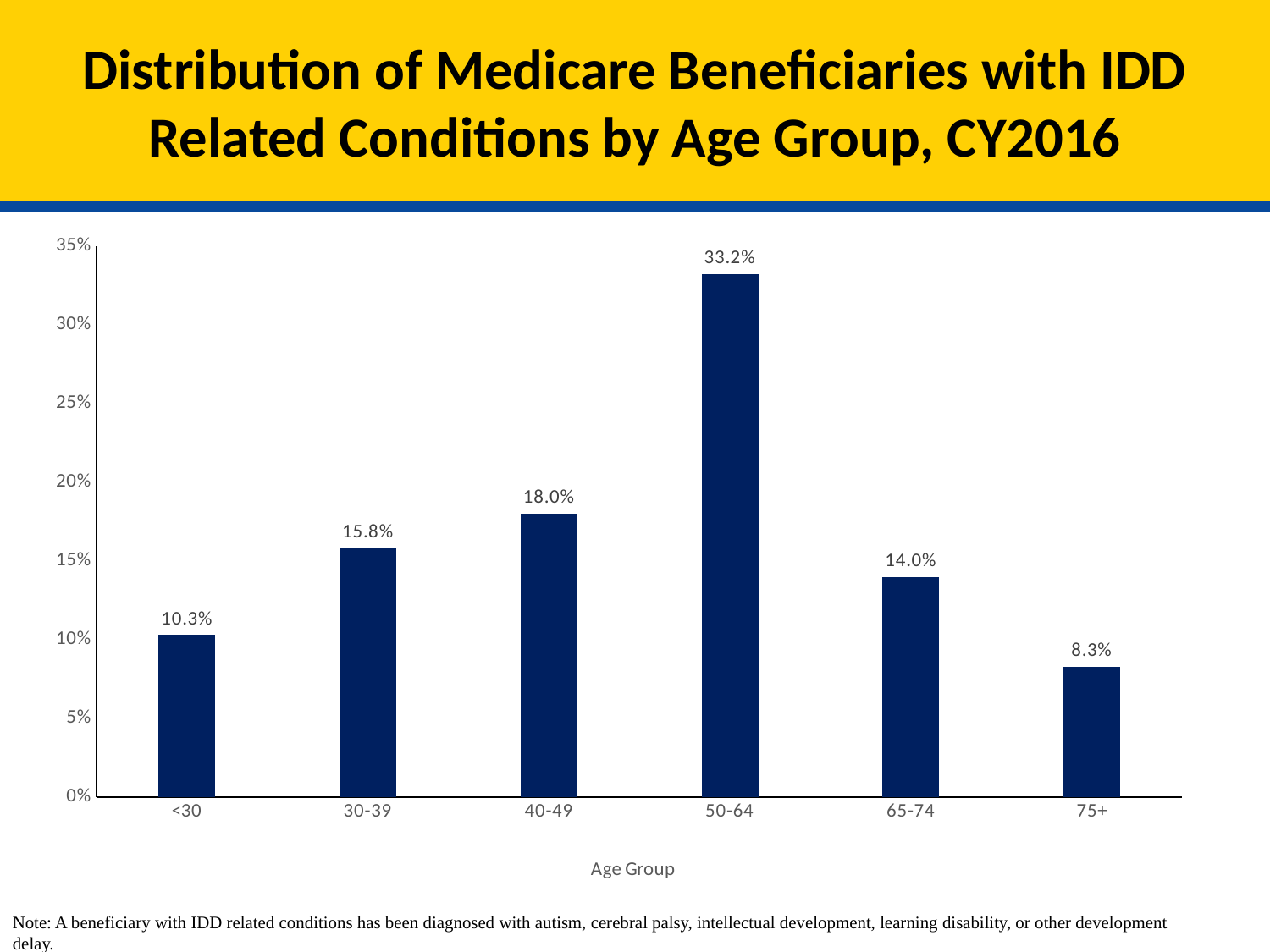
Which age group has the lowest share of beneficiaries? 75+ What is the value shown for the <30 age group? 10.3% Is the value for the 30-39 age group greater or less than 15%? greater What is the label of the x axis? Age Group What percentage of Medicare beneficiaries with IDD related conditions are in the 50-64 age group? 33.2% How many age groups are shown on the chart? 6 What is the value shown for the 65-74 age group? 14.0% Which has a larger value, the 40-49 age group or the 65-74 age group? 40-49 What is the difference between the values for the 50-64 and 40-49 age groups? 15.2% What is the difference between the values for the 30-39 and <30 age groups? 5.5% What kind of chart is shown on the slide? Bar chart Which age group has the highest share of beneficiaries? 50-64